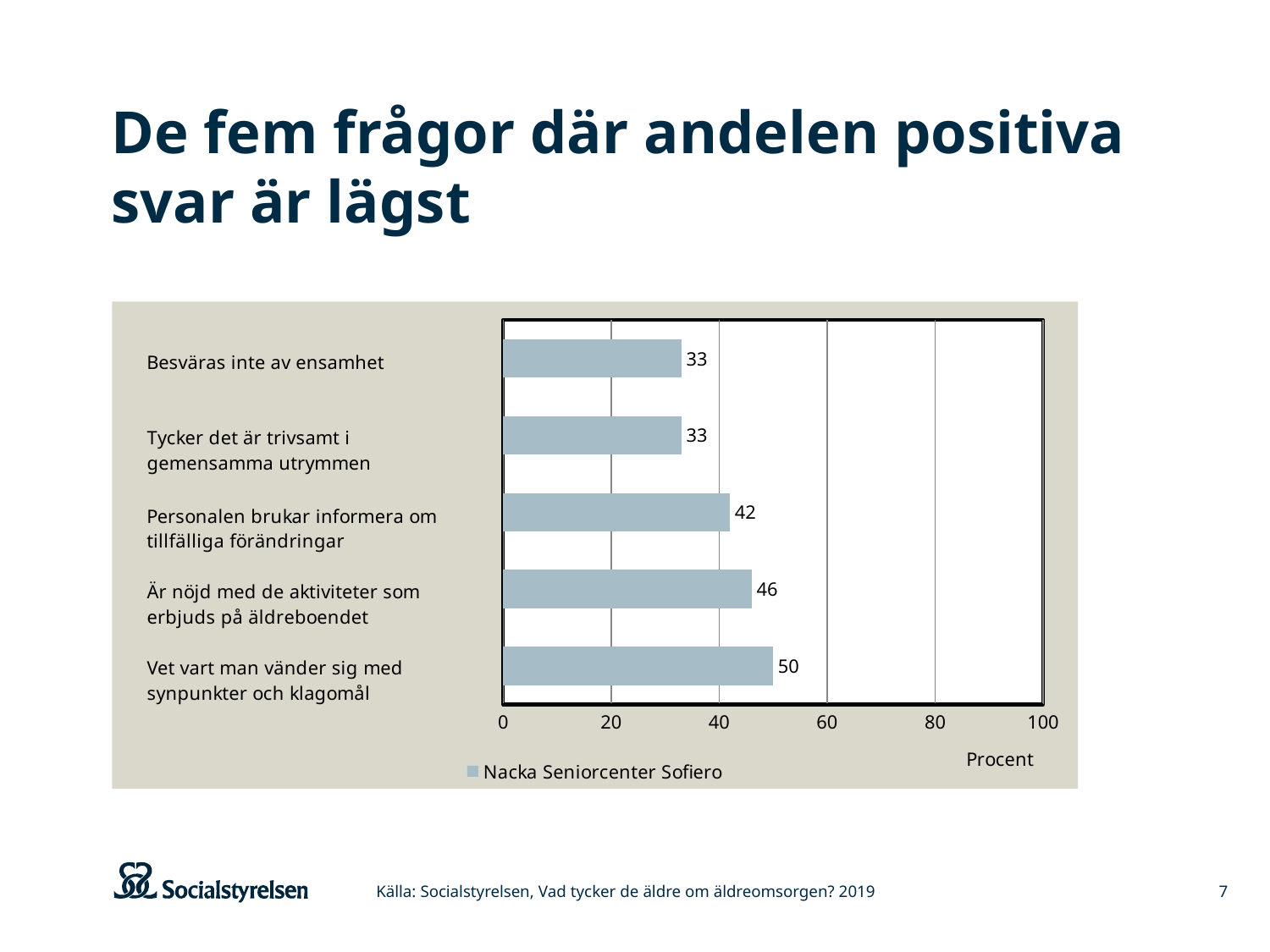
What is the difference between the values for "Är nöjd med de aktiviteter som erbjuds på äldreboendet" and "Personalen brukar informera om tillfälliga förändringar"? 4 Which category has the highest value? Vet vart man vänder sig med synpunkter och klagomål What is the value for "Personalen brukar informera om tillfälliga förändringar"? 42 What is the value for "Vet vart man vänder sig med synpunkter och klagomål"? 50 What is the value for "Besväras inte av ensamhet"? 33 What series name does the legend show? Nacka Seniorcenter Sofiero What kind of chart is shown on the slide? bar chart Is the value for "Är nöjd med de aktiviteter som erbjuds på äldreboendet" greater or less than 40? greater What is the value for "Är nöjd med de aktiviteter som erbjuds på äldreboendet"? 46 Which is larger, the value for "Personalen brukar informera om tillfälliga förändringar" or the value for "Tycker det är trivsamt i gemensamma utrymmen"? Personalen brukar informera om tillfälliga förändringar How many categories are shown in the chart? 5 What is the difference between the values for "Vet vart man vänder sig med synpunkter och klagomål" and "Besväras inte av ensamhet"? 17